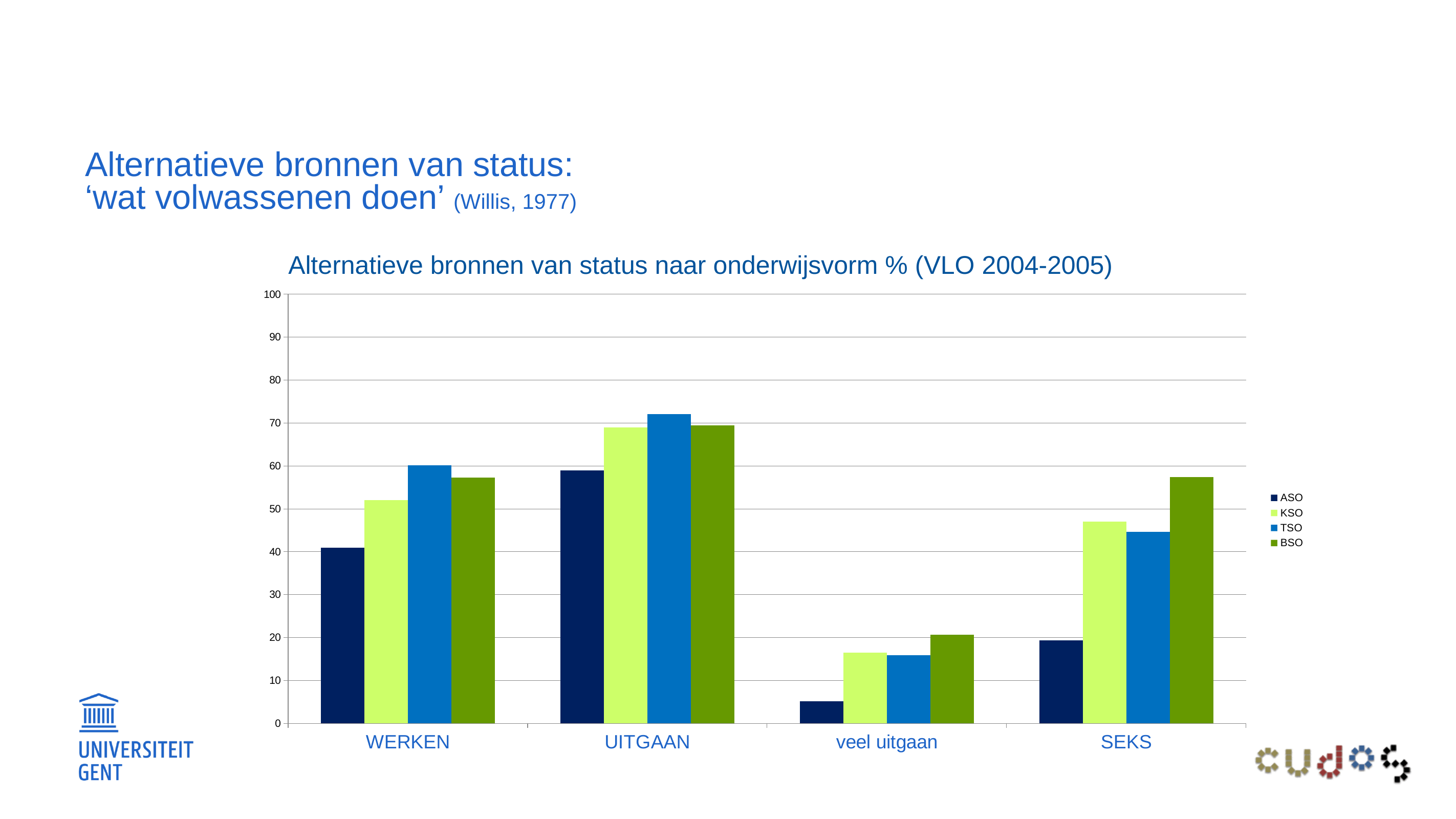
Which series has the lowest value for UITGAAN? ASO What kind of chart is shown on the slide? bar chart How many categories are shown on the x axis? 4 Is the value for TSO in UITGAAN greater or less than 60? greater How many series does the legend list? 4 Which series has the highest value for WERKEN? TSO What is the title of the chart? Alternatieve bronnen van status naar onderwijsvorm % (VLO 2004-2005) Is the value for ASO in WERKEN greater or less than 50? less Which series has the lowest value for SEKS? ASO Which series has the highest value for SEKS? BSO Is the value for ASO in veel uitgaan greater or less than 10? less Which series has the highest value for veel uitgaan? BSO